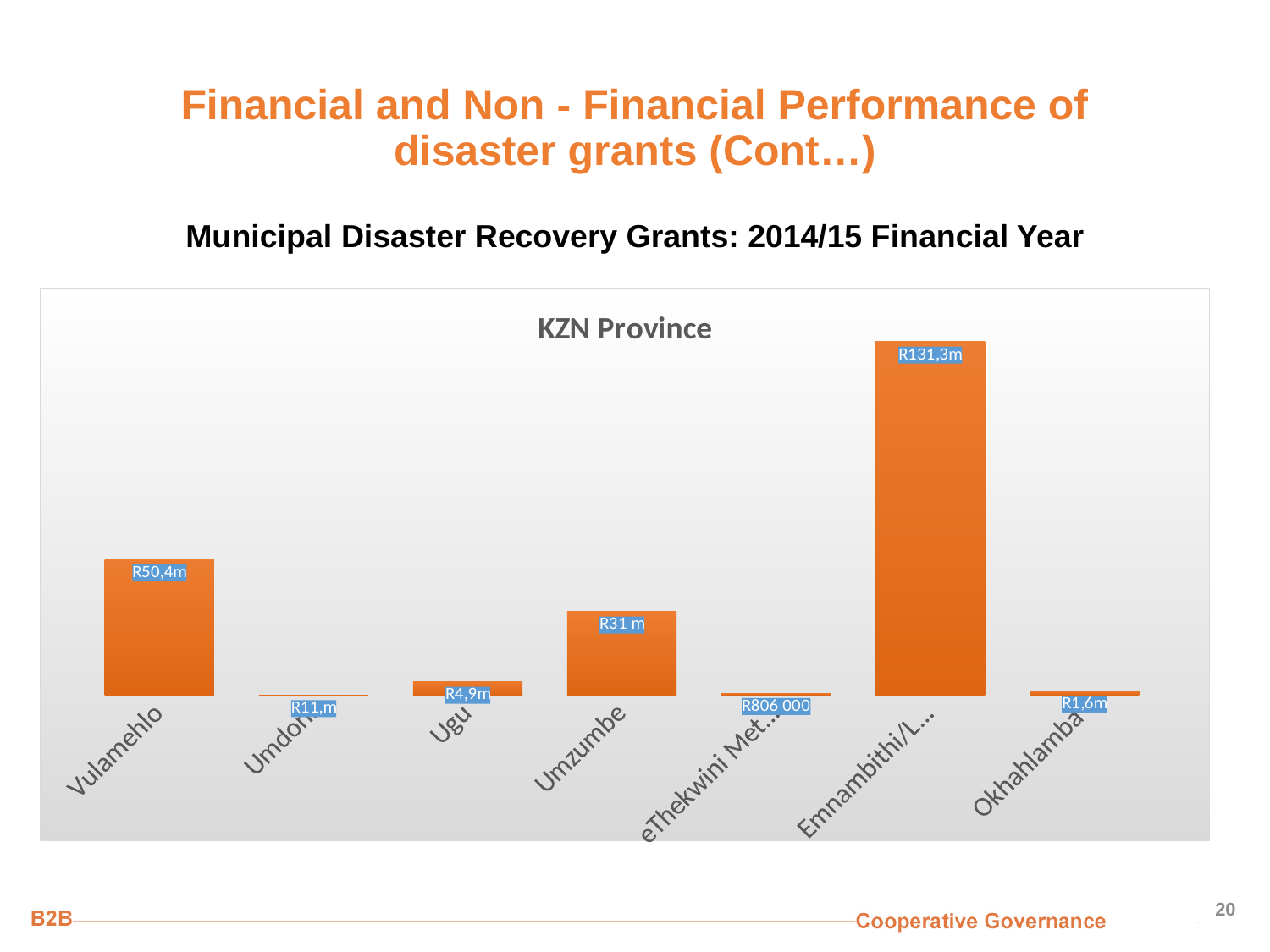
What is the value for Ugu? R4,9m What is the title of the chart? KZN Province Which is larger, the value for Vulamehlo or the value for Umzumbe? Vulamehlo What is the value for Okhahlamba? R1,6m How many municipalities are shown on the x axis? 7 What is the value for Vulamehlo? R50,4m What kind of chart is shown? bar chart What is the difference between the values for Vulamehlo and Umzumbe? R19,4m What is the value for the bar labelled Emnambithi/L...? R131,3m Which municipality has the highest value? Emnambithi/L... What is the value for Umzumbe? R31 m Which municipality has the lowest value? Umdoni